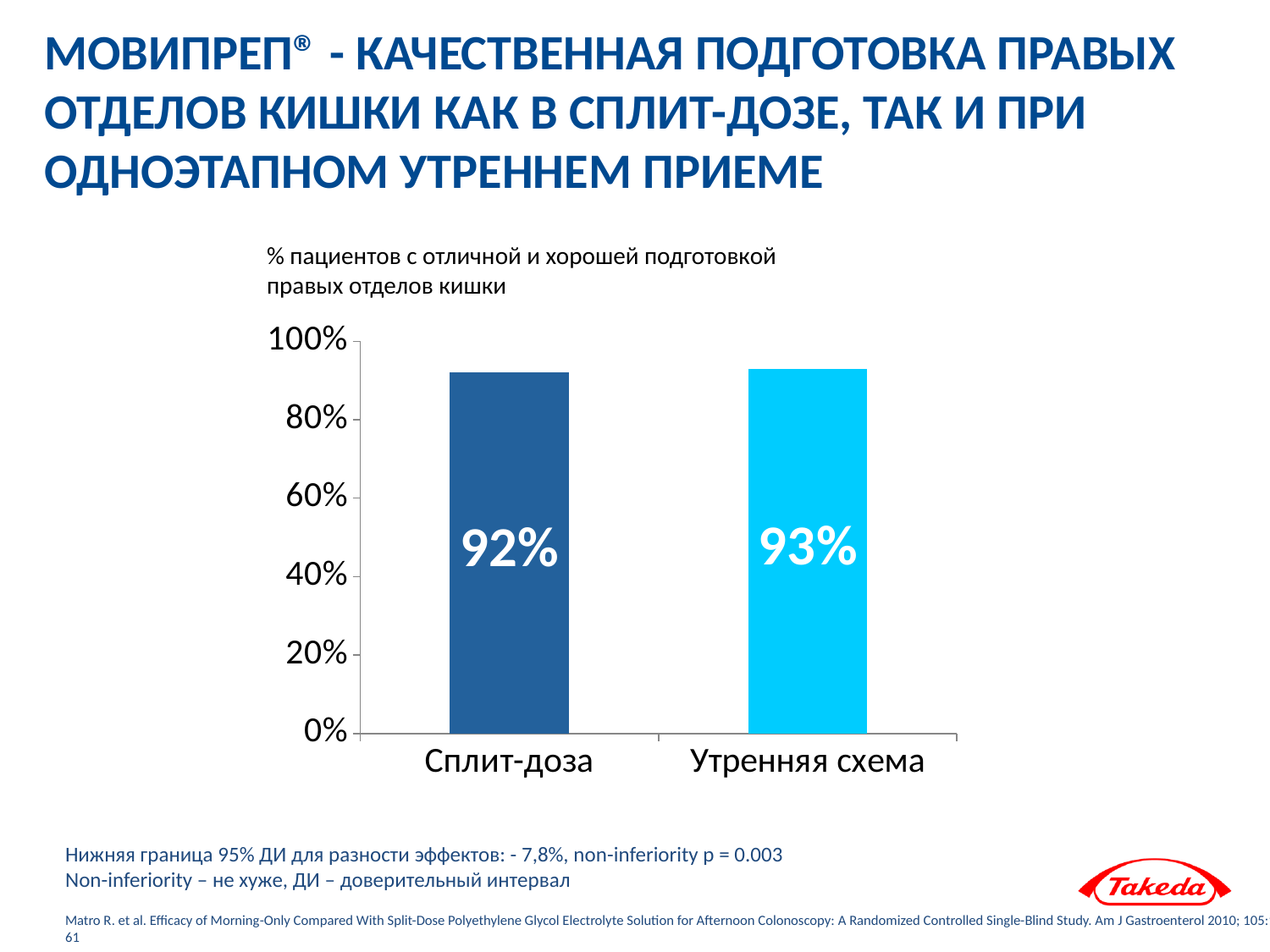
What colour is the bar for Утренняя схема? light blue Is the value for Утренняя схема greater or less than 100%? less Is the value for Сплит-доза greater or less than 80%? greater What is the value for Сплит-доза? 92% What kind of chart is shown on the slide? bar chart What is the value for Утренняя схема? 93% What is the difference between the values for Утренняя схема and Сплит-доза? 1% What is the highest tick value shown on the vertical axis? 100% How many categories are shown on the chart? 2 Which category has the lower value? Сплит-доза Which category has the higher value? Утренняя схема